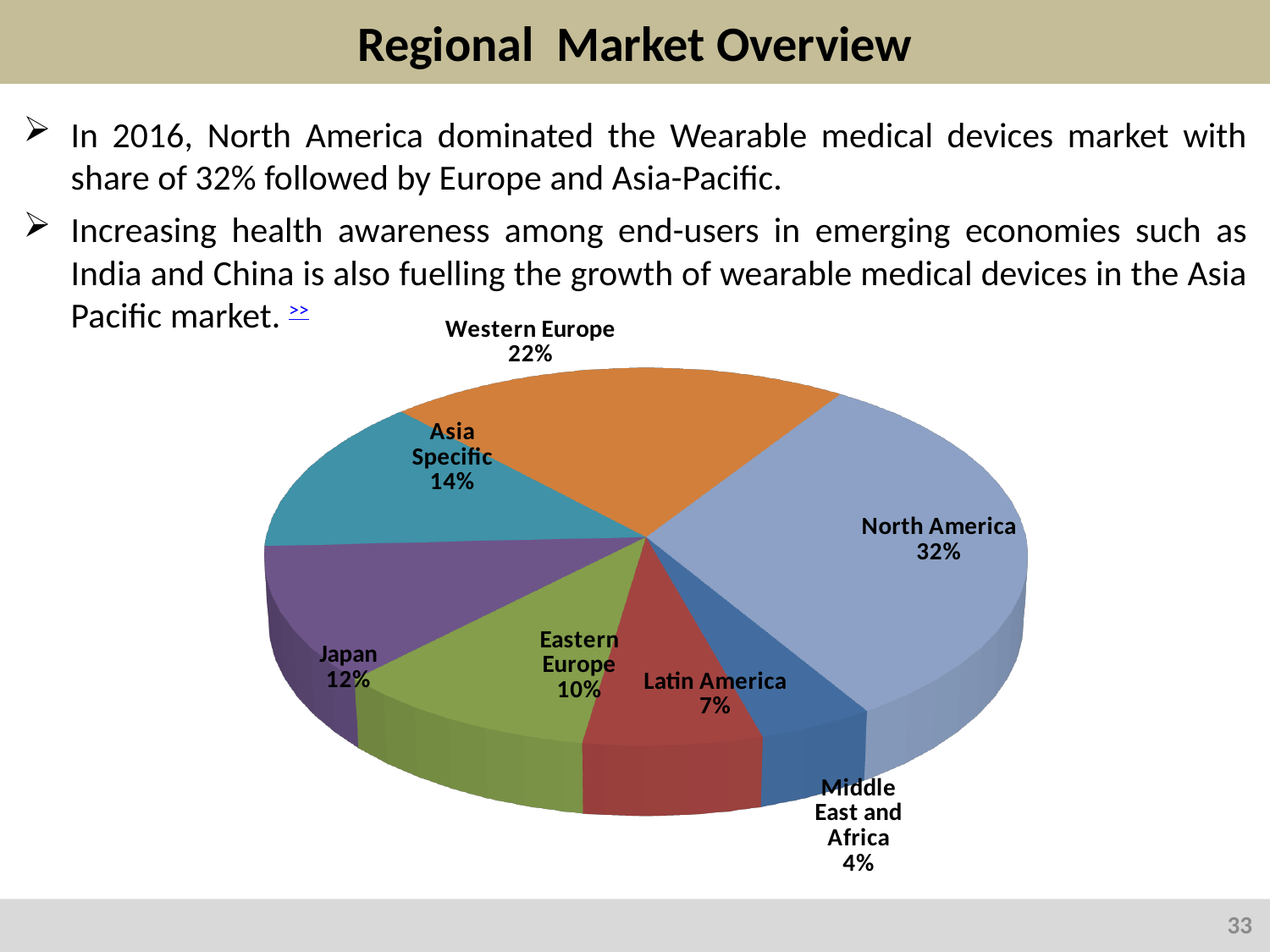
Which is larger, the share for Asia Specific or the share for Japan? Asia Specific What is the value shown for Middle East and Africa? 4% What is the difference between the shares of Eastern Europe and Latin America? 3% What is the value shown for Japan? 12% What is the value shown for Western Europe? 22% Which region has the smallest slice of the pie? Middle East and Africa How many slices does the pie chart have? 7 What share of the pie does North America hold? 32% What colour is the North America slice? light blue What is the difference between the shares of North America and Western Europe? 10% What kind of chart is shown on the slide? pie chart Which region has the largest slice of the pie? North America